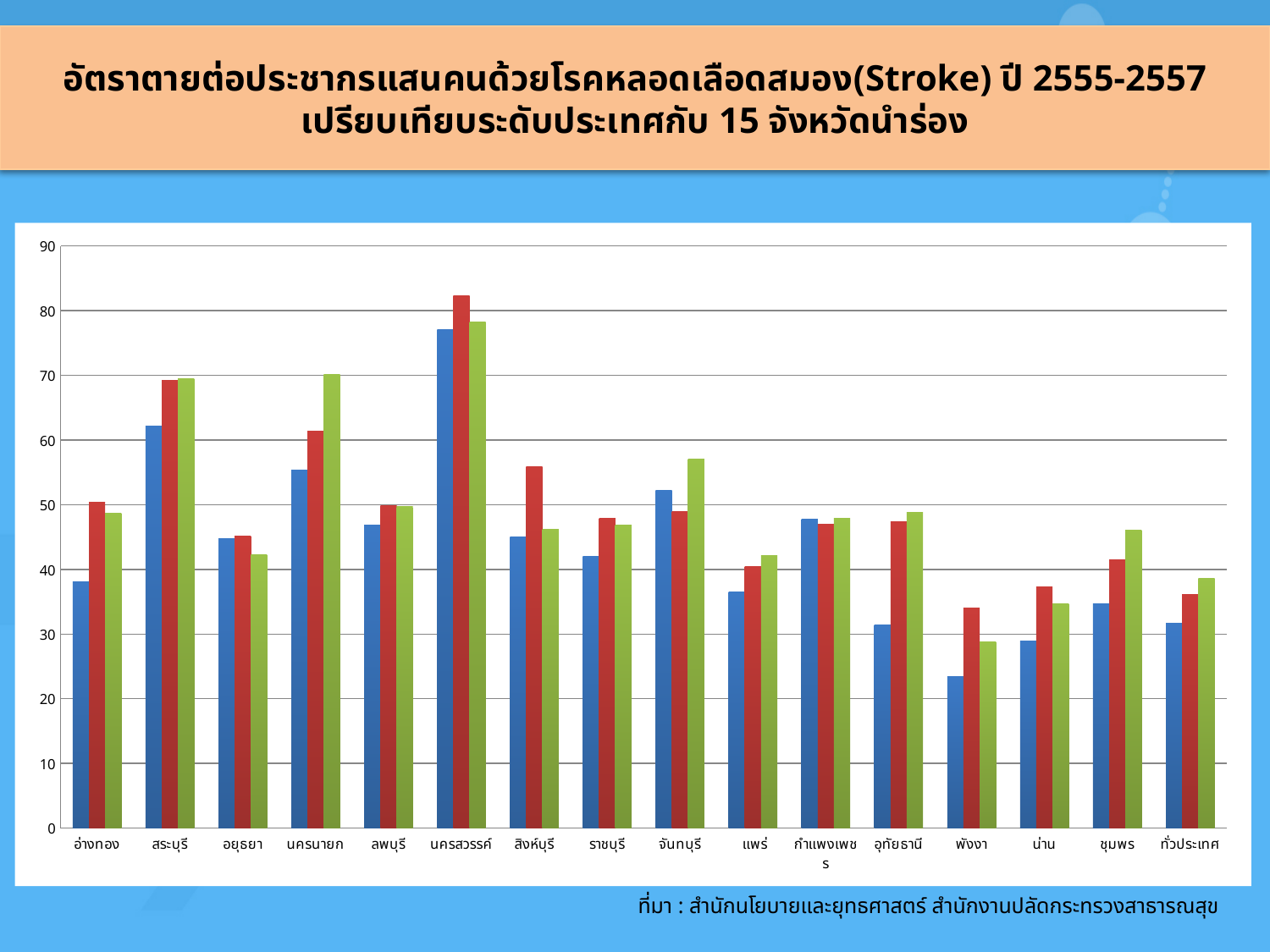
How many categories are shown along the x axis of the chart? 16 Which has the taller blue bar, สระบุรี or อ่างทอง? สระบุรี Is the green bar for จันทบุรี greater or less than 50? greater How many bars are plotted for each category on the chart? 3 Which category has the tallest bar on the chart? นครสวรรค์ Which category has the shortest bar on the chart? พังงา Is the blue bar for พังงา greater or less than 30? less Is the blue bar for อ่างทอง greater or less than 40? less Which has the taller green bar, นครนายก or ลพบุรี? นครนายก What kind of chart is shown on the slide? bar chart